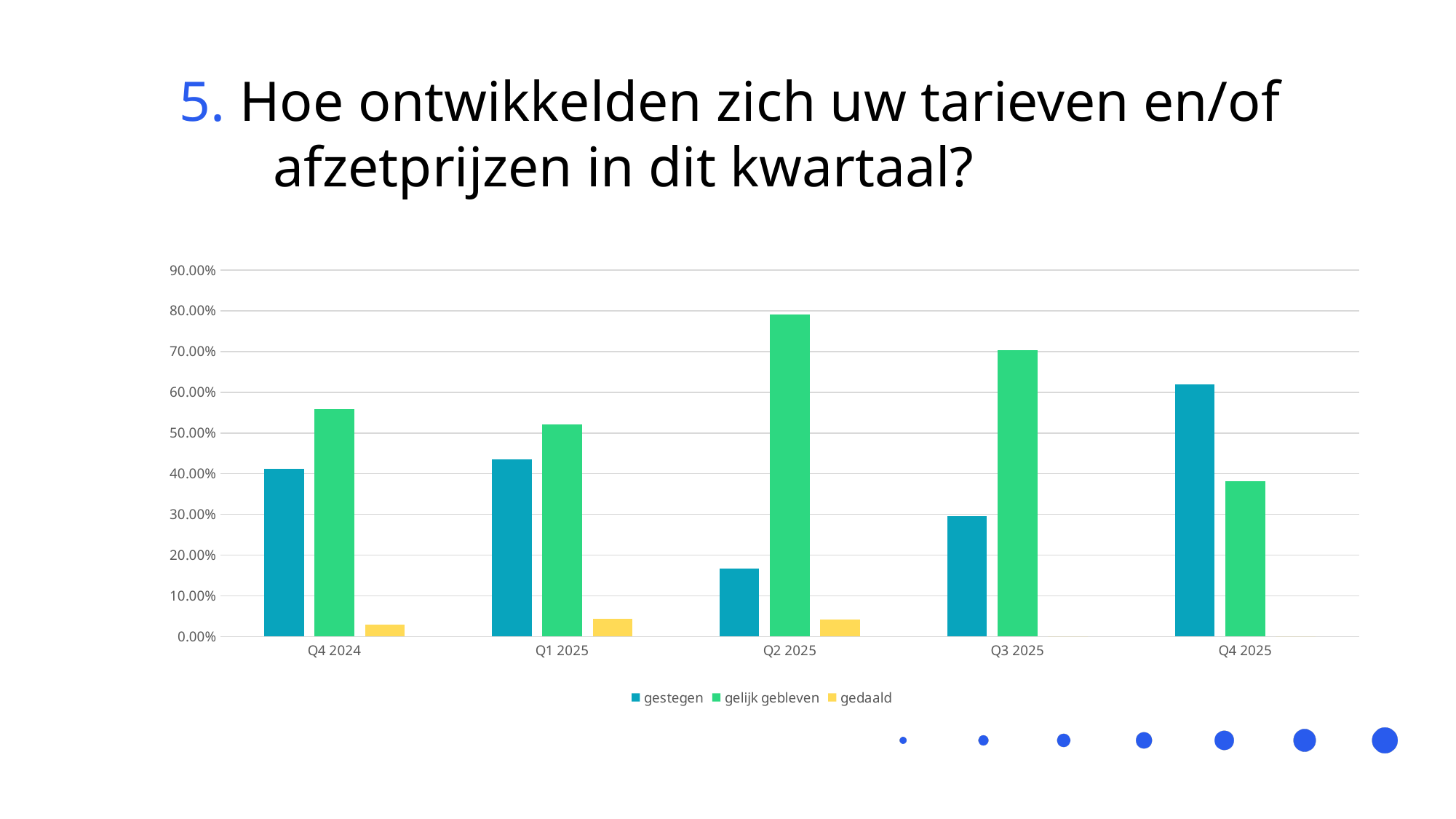
Which quarter has the highest value for 'gelijk gebleven'? Q2 2025 How many quarters are shown on the x axis? 5 How many series does the legend list? 3 What kind of chart is shown on the slide? bar chart Which quarter has the highest value for 'gestegen'? Q4 2025 Which quarter has the lowest value for 'gestegen'? Q2 2025 Is the value for 'gestegen' in Q4 2025 greater or less than 60.00%? greater In Q4 2025, which is larger: 'gestegen' or 'gelijk gebleven'? gestegen Which colour represents the 'gedaald' series in the legend? yellow In Q4 2024, which is larger: 'gestegen' or 'gelijk gebleven'? gelijk gebleven Is the value for 'gelijk gebleven' in Q2 2025 greater or less than 70.00%? greater